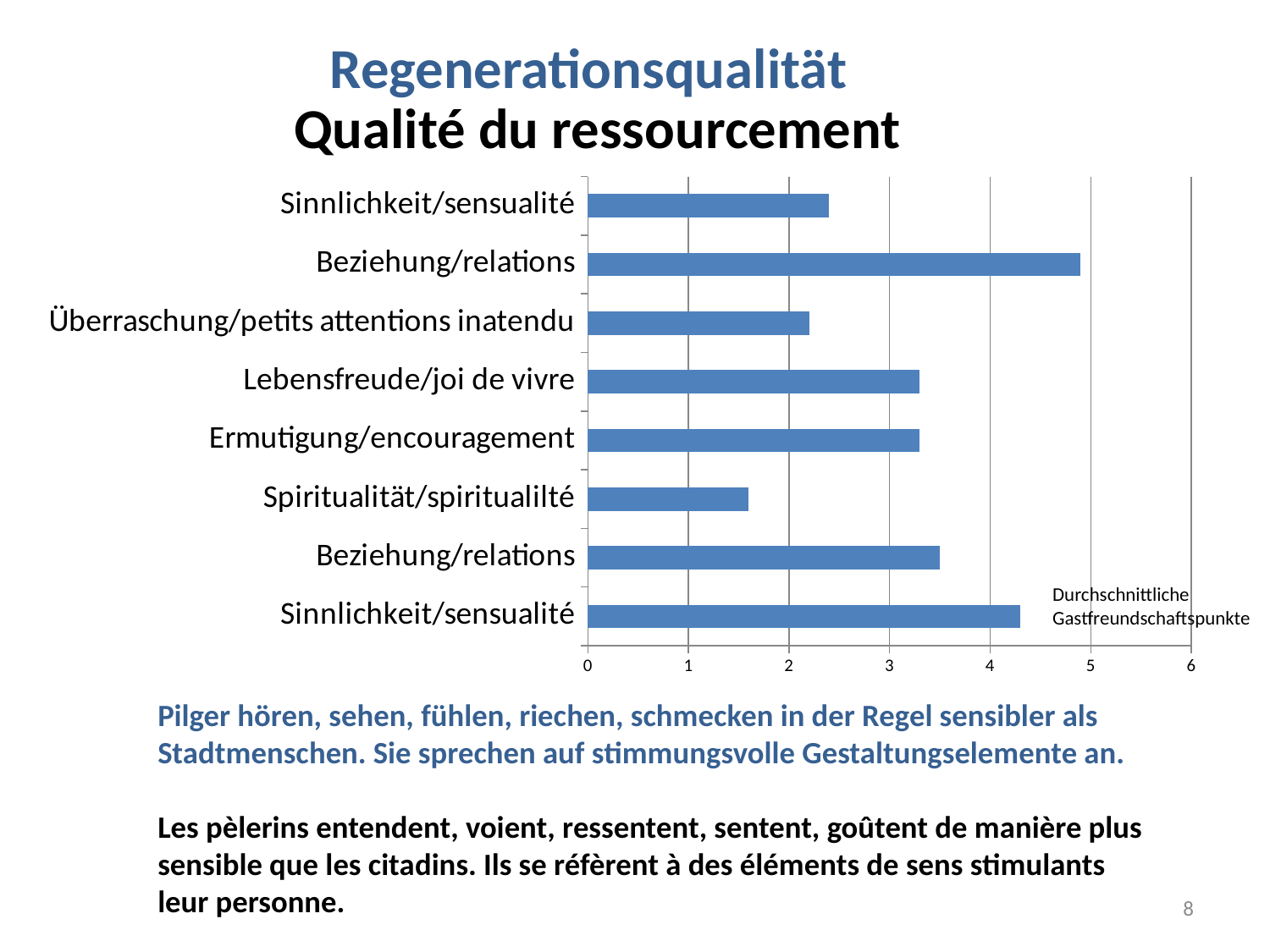
Which category has the longest bar in the chart? Beziehung/relations (the upper one) Is the value for Lebensfreude/joi de vivre greater or less than 3? greater Is the value for Spiritualität/spiritualilté greater or less than 2? less Is the value for Überraschung/petits attentions inatendu greater or less than 3? less Which is larger, the value for Überraschung/petits attentions inatendu or the value for Lebensfreude/joi de vivre? Lebensfreude/joi de vivre What is the highest value shown on the chart's x axis? 6 What kind of chart is shown on the slide? bar chart Which category has the shortest bar in the chart? Spiritualität/spiritualilté How many categories (bars) does the chart show? 8 Which Sinnlichkeit/sensualité bar is longer, the top one or the bottom one? the bottom one What is the legend entry shown on the chart? Durchschnittliche Gastfreundschaftspunkte